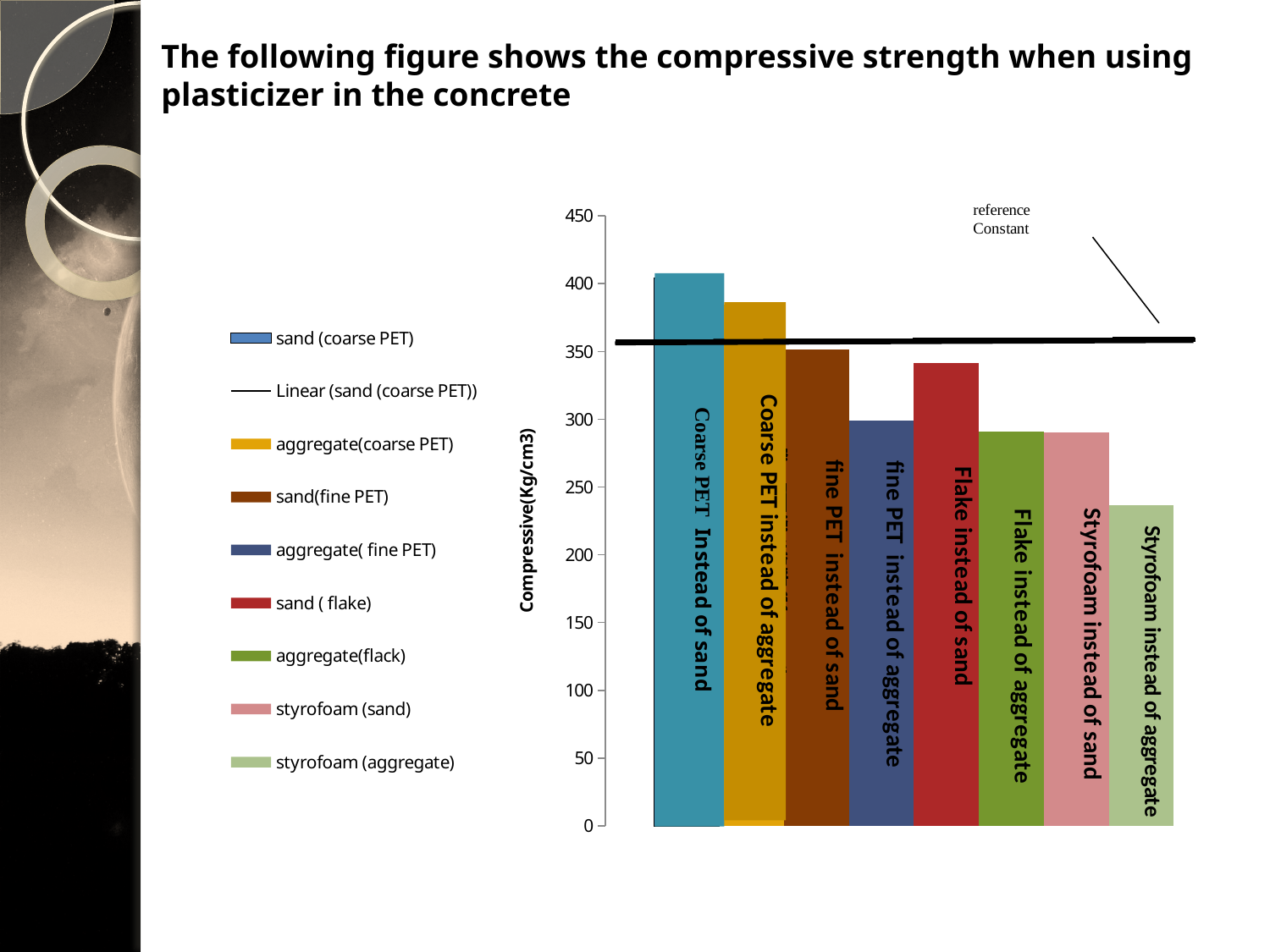
Is the value for Flake instead of sand greater or less than 300? greater Is the value for Coarse PET instead of sand greater or less than 350? greater How many bars are plotted in the chart? 8 Is the value for Coarse PET instead of aggregate greater or less than 400? less Which bar has the highest compressive strength? Coarse PET instead of sand Which is larger, the value for fine PET instead of aggregate or the value for Flake instead of sand? Flake instead of sand What is the label on the vertical axis of the chart? Compressive(Kg/cm3) Which is larger, the value for Coarse PET instead of sand or the value for Coarse PET instead of aggregate? Coarse PET instead of sand Which bar has the lowest compressive strength? Styrofoam instead of aggregate What kind of chart is shown on the slide? bar chart How many entries does the legend list? 9